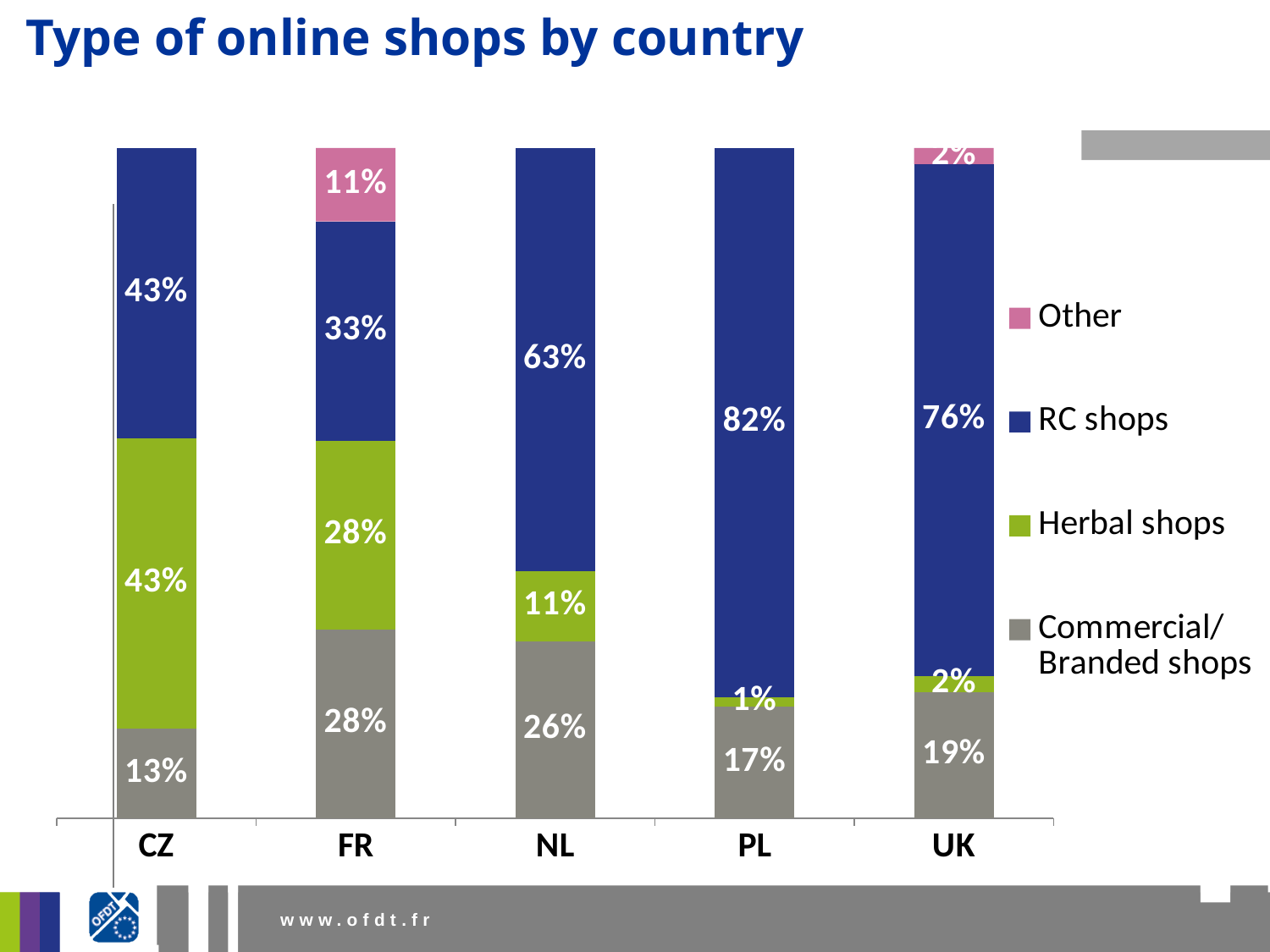
What is the value for RC shops in PL? 82% How many series does the legend list? 4 What is the value for Herbal shops in NL? 11% Which is larger: the Commercial/Branded shops value for FR or for NL? FR What is the value for Other in FR? 11% How many countries are shown on the x axis? 5 Which country has the highest value for RC shops? PL What is the title of the chart? Type of online shops by country What kind of chart is shown on the slide? Stacked bar chart Which country has the lowest value for Herbal shops? PL What is the value for Commercial/Branded shops in CZ? 13% What is the difference between the RC shops values for UK and NL? 13%